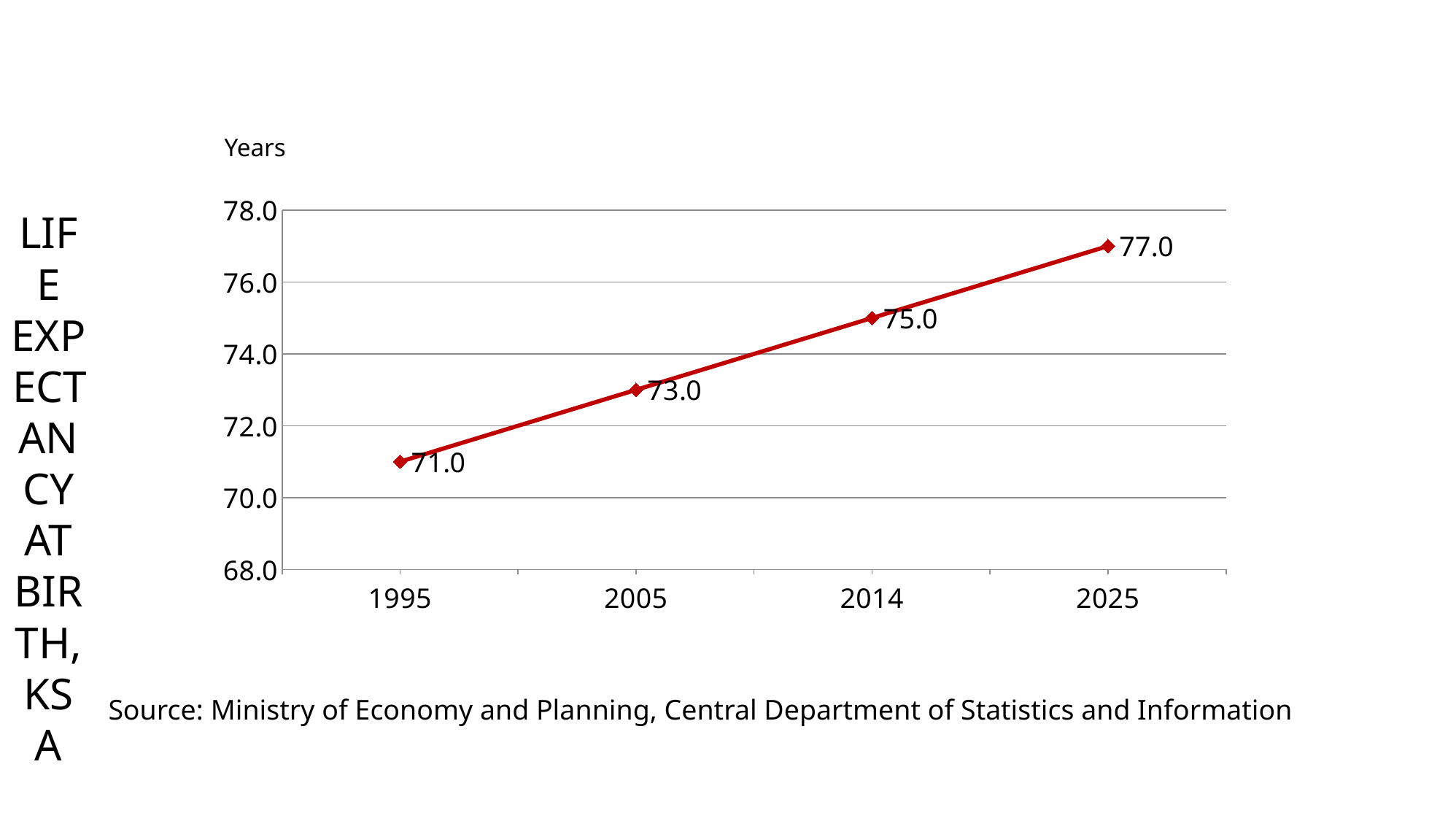
What is the difference between the life expectancy values for 2025 and 1995? 6.0 Which is larger, the value for 2005 or the value for 2014? 2014 Is the value for 2014 greater or less than 74.0? greater What is the life expectancy value shown for 2025? 77.0 What kind of chart is shown on the slide? line chart How many data points are plotted on the chart? 4 What is the life expectancy value shown for 2005? 73.0 What is the life expectancy value shown for 1995? 71.0 Do the values rise or fall from 1995 to 2025? rise What is the life expectancy value shown for 2014? 75.0 Which year has the lowest life expectancy value on the chart? 1995 Which year has the highest life expectancy value on the chart? 2025